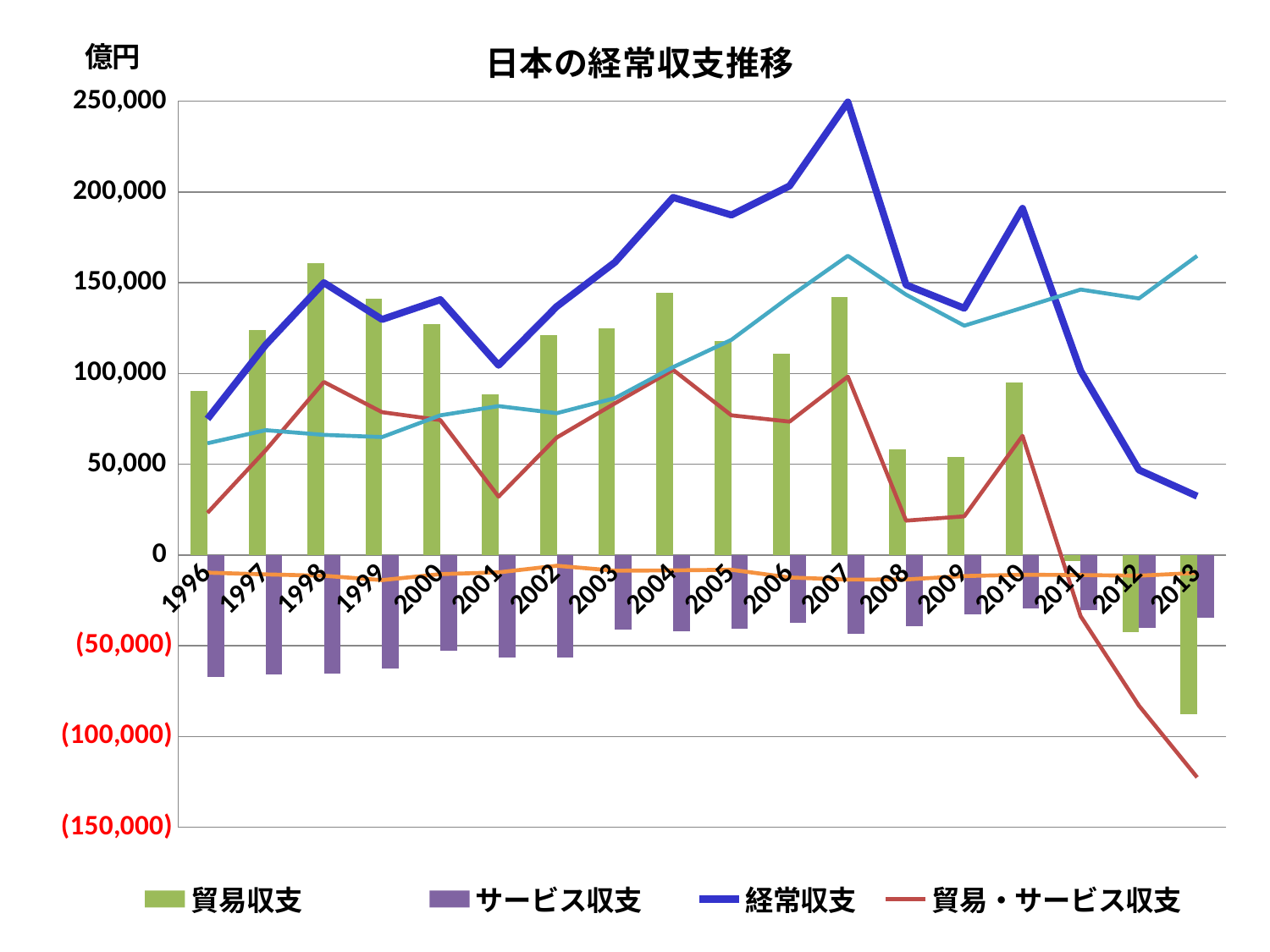
In which year is the 経常収支 line at its lowest value? 2013 What is the title of the chart? 日本の経常収支推移 What unit is shown at the top of the vertical axis? 億円 What kind of chart is shown on the slide? A combined bar and line chart Is the value of 経常収支 in 2007 greater or less than 200,000? greater In which year does the 経常収支 line reach its highest value? 2007 Does the 経常収支 line rise or fall from 2010 to 2013? It falls Is the value of 貿易収支 in 2013 greater or less than (50,000)? less Which year has the larger 経常収支 value, 2010 or 2011? 2010 In which year is the 貿易収支 bar the tallest? 1998 How many years are shown on the x axis of the chart? 18 How many series does the legend list? 4